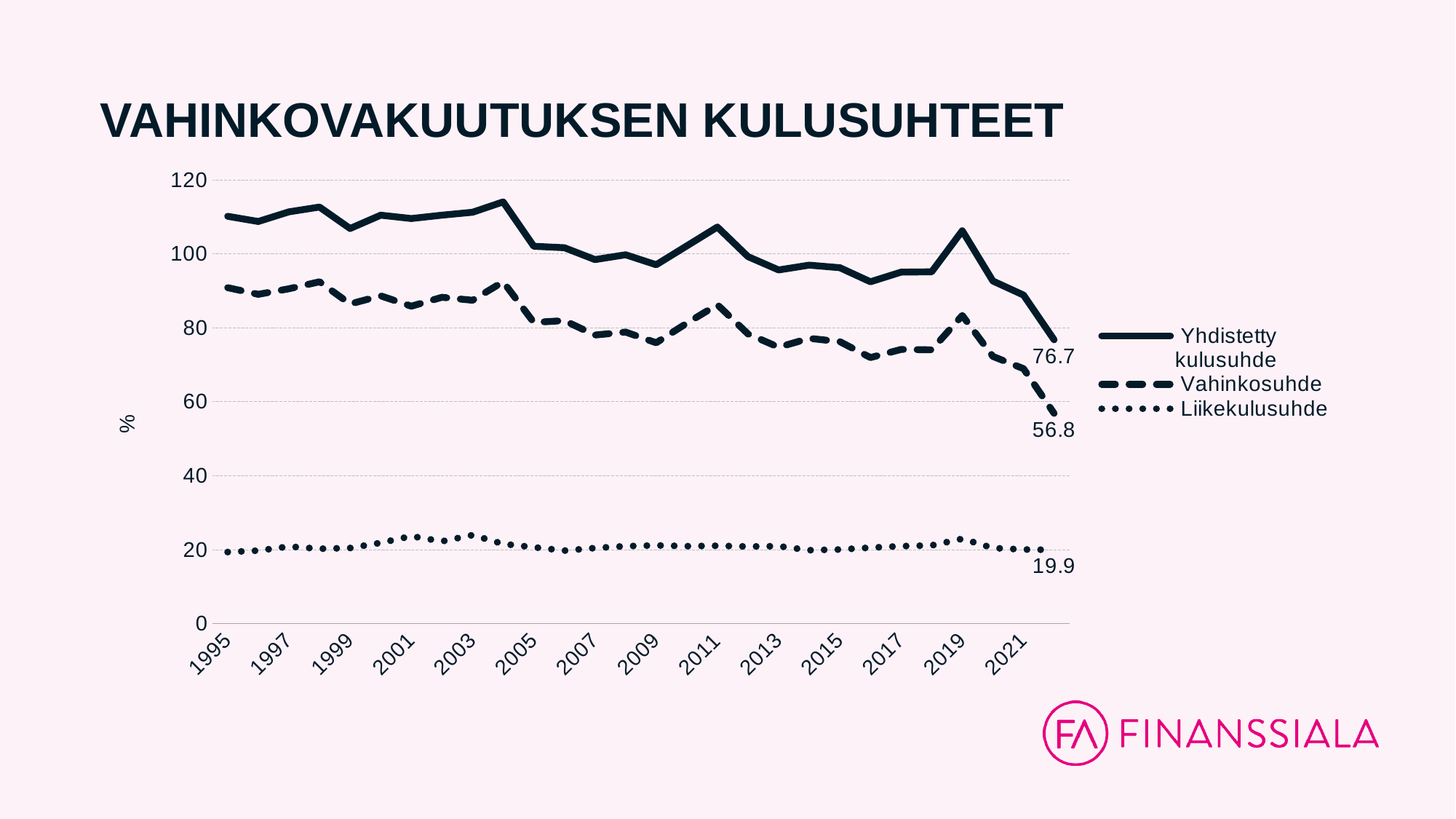
What is the final labelled value of the Yhdistetty kulusuhde line? 76.7 What is the final labelled value of the Vahinkosuhde line? 56.8 What is the title of the chart? VAHINKOVAKUUTUKSEN KULUSUHTEET How many series does the legend list? 3 What is the difference between the final labelled values of Yhdistetty kulusuhde and Vahinkosuhde? 19.9 What is the difference between the final labelled values of Vahinkosuhde and Liikekulusuhde? 36.9 Is the value for Yhdistetty kulusuhde in 1995 greater or less than 100? greater Which series has the lowest values across the whole period? Liikekulusuhde What kind of chart is shown on the slide? line chart Which series has the highest values across the whole period? Yhdistetty kulusuhde Does the Yhdistetty kulusuhde line overall rise or fall from 1995 to the end of the period? fall What is the final labelled value of the Liikekulusuhde line? 19.9